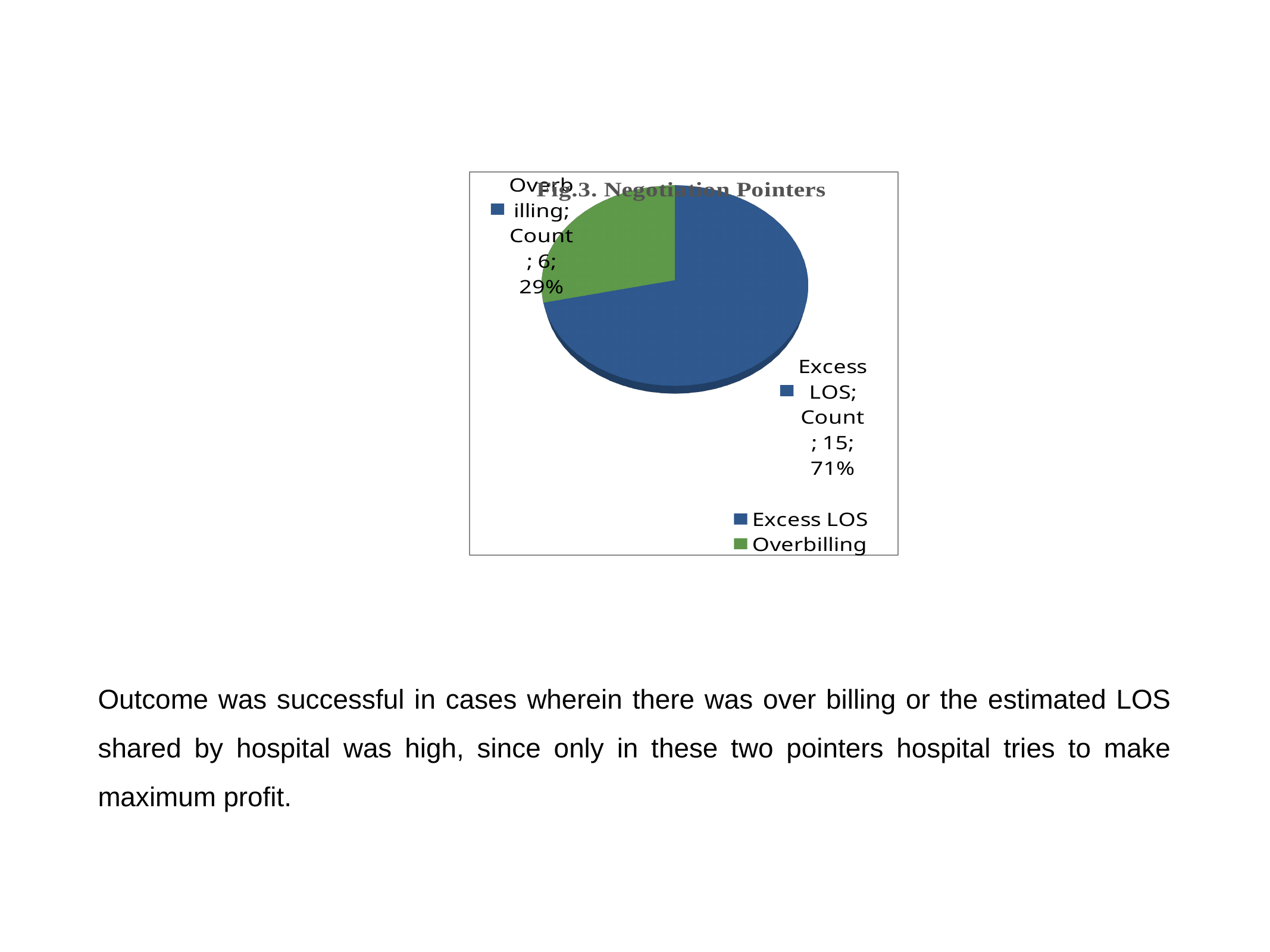
What colour is the Overbilling slice? Green Which category has the smallest slice of the pie? Overbilling What is the difference between the counts for Excess LOS and Overbilling? 9 What is the count for Overbilling? 6 Which is larger, the count for Excess LOS or the count for Overbilling? Excess LOS What share of the pie does Overbilling represent? 29% What is the count for Excess LOS? 15 How many categories are shown in the pie chart? 2 Which category has the largest slice of the pie? Excess LOS What share of the pie does Excess LOS represent? 71% What kind of chart is shown on the slide? Pie chart What is the title of the chart? Fig.3. Negotiation Pointers